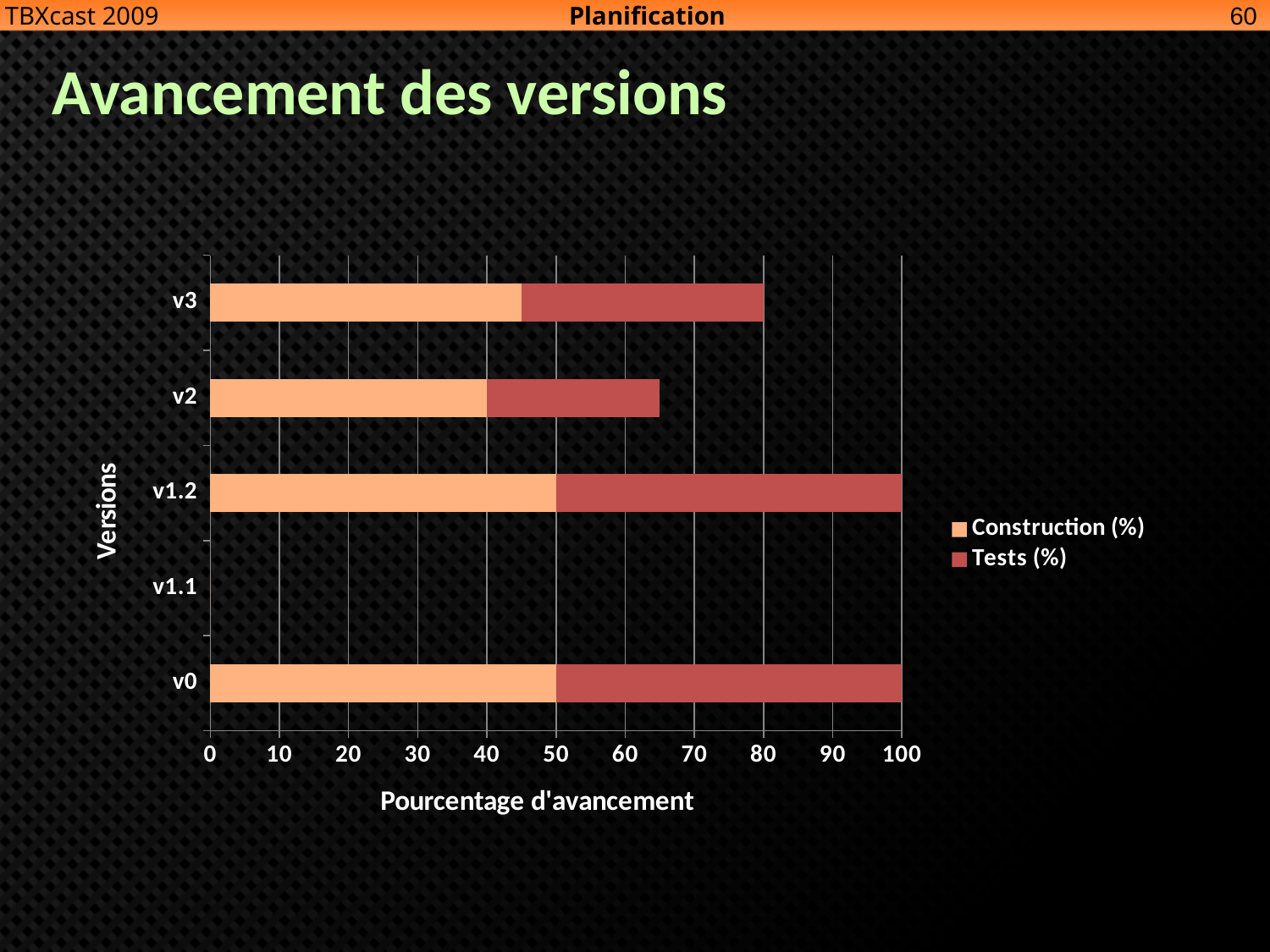
What is the total length of the stacked bar for v1.2? 100 Which version has the shortest stacked bar? v1.1 How many series does the legend list? 2 What is the label of the horizontal axis? Pourcentage d'avancement Is the Construction (%) value for v3 greater or less than 50? less Which has the longer stacked bar, v3 or v2? v3 What is the Construction (%) value for v0? 50 How many versions are listed on the vertical axis? 5 What is the Construction (%) value for v2? 40 What kind of chart is shown on the slide? bar chart Is the total of the stacked bar for v2 greater or less than 60? greater What is the total length of the stacked bar for v3? 80